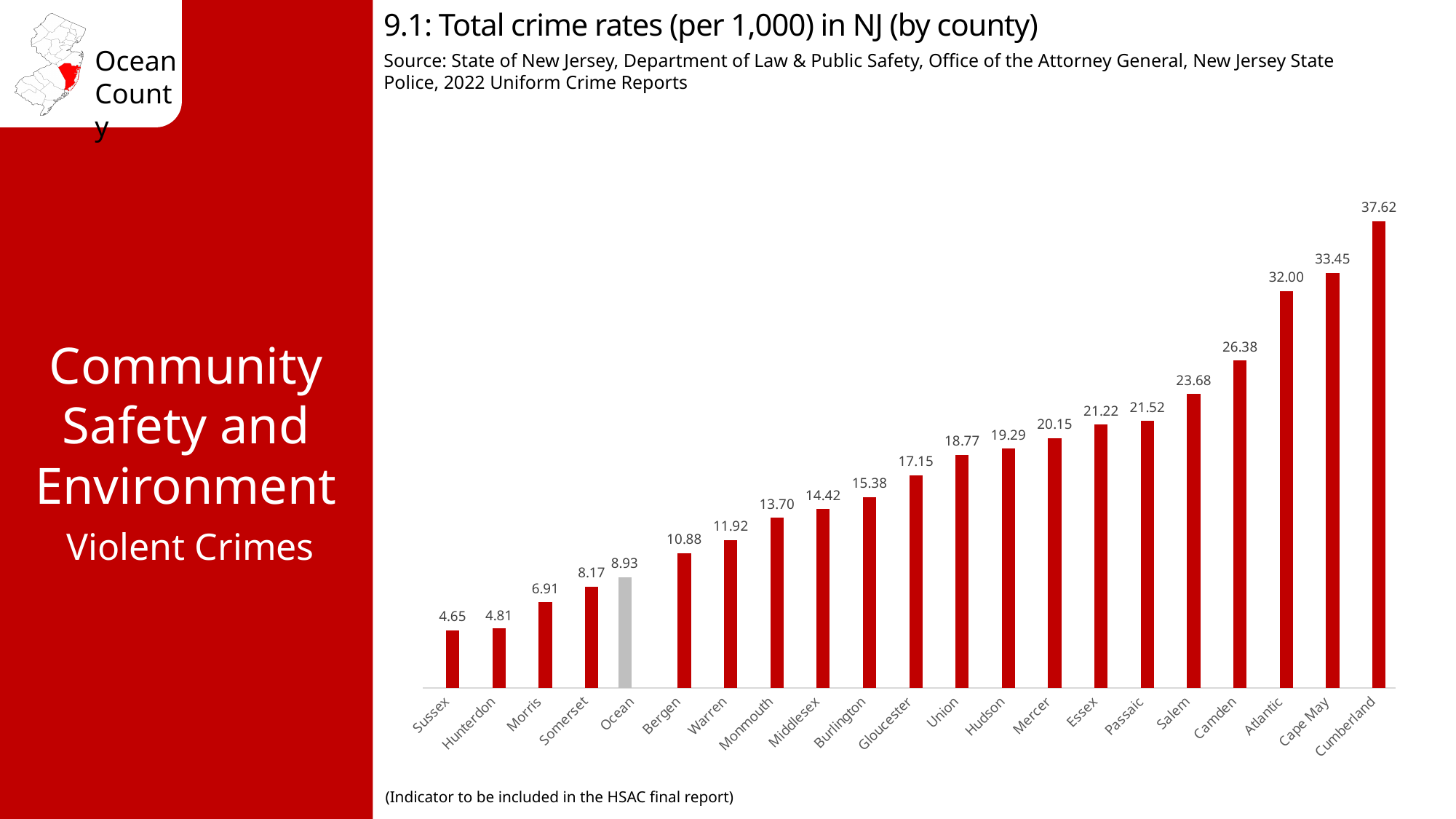
What is the difference between the total crime rates of Cumberland and Sussex? 32.97 What is the total crime rate (per 1,000) for Cumberland county? 37.62 What is the total crime rate (per 1,000) for Ocean county? 8.93 What kind of chart is used to show the total crime rates? Bar chart What is the total crime rate (per 1,000) for Monmouth county? 13.70 Which county's bar is coloured grey instead of red? Ocean How many counties are shown in the chart? 21 Do the values rise or fall moving from left to right along the x axis? Rise Which county has a higher total crime rate, Cape May or Atlantic? Cape May Which county has the highest total crime rate? Cumberland What is the difference between the total crime rates of Ocean and Sussex? 4.28 Which county has the lowest total crime rate? Sussex